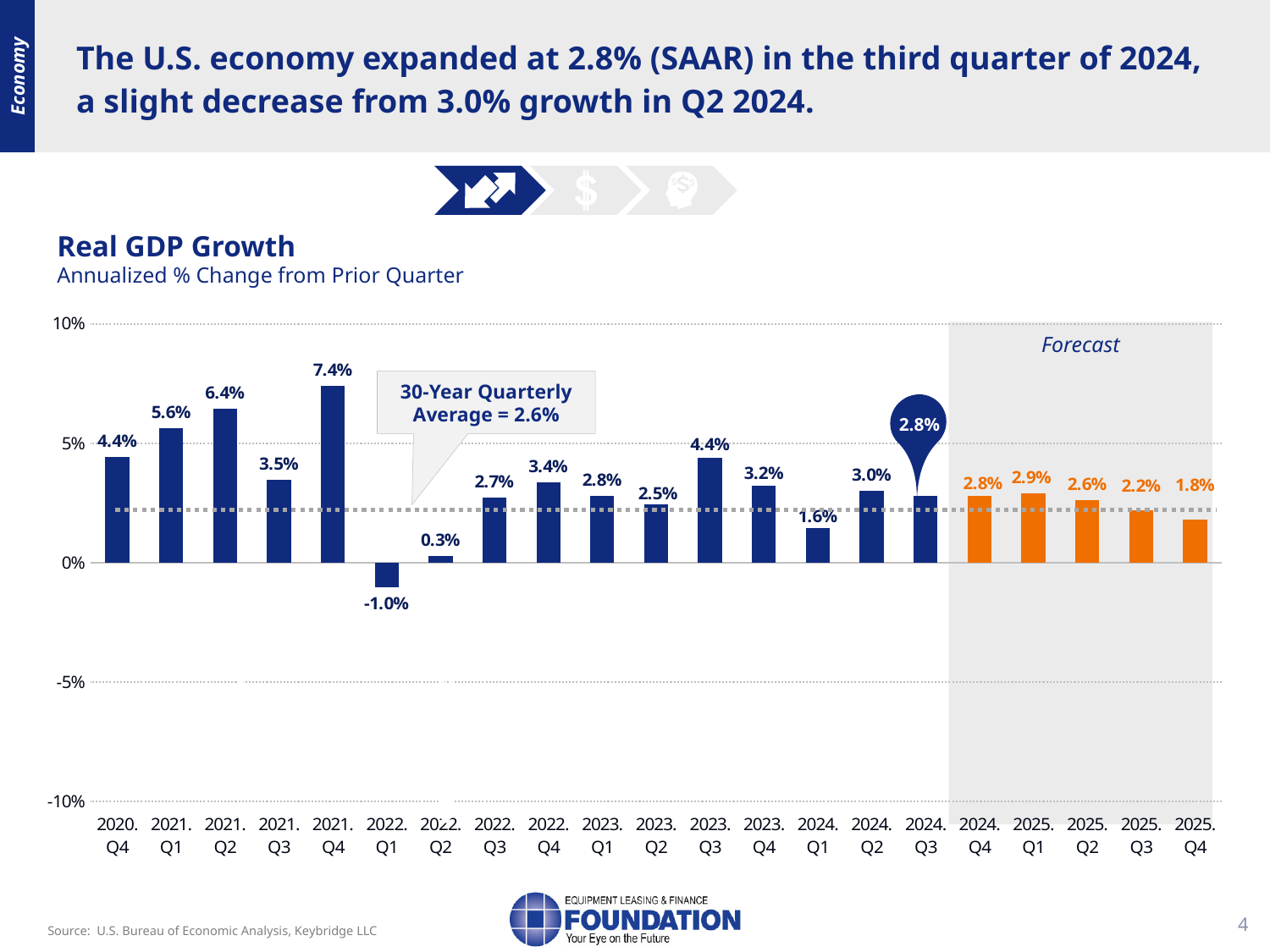
Which quarter has the highest Real GDP Growth value? 2021 Q4 Which quarter has the lowest Real GDP Growth value? 2022 Q1 What is the Real GDP Growth value for 2021 Q4? 7.4% Do the forecast values from 2025 Q1 to 2025 Q4 rise or fall? Fall What kind of chart is the Real GDP Growth chart? Bar chart What 30-year quarterly average is shown in the callout on the Real GDP Growth chart? 2.6% What is the Real GDP Growth value for 2024 Q1? 1.6% What is the forecast Real GDP Growth value for 2025 Q4? 1.8% What is the Real GDP Growth value for 2022 Q1? -1.0% Which is larger, the Real GDP Growth value for 2021 Q2 or 2021 Q3? 2021 Q2 What is the difference between the Real GDP Growth values for 2024 Q2 and 2024 Q3? 0.2% How many quarters are plotted in the Real GDP Growth chart? 21